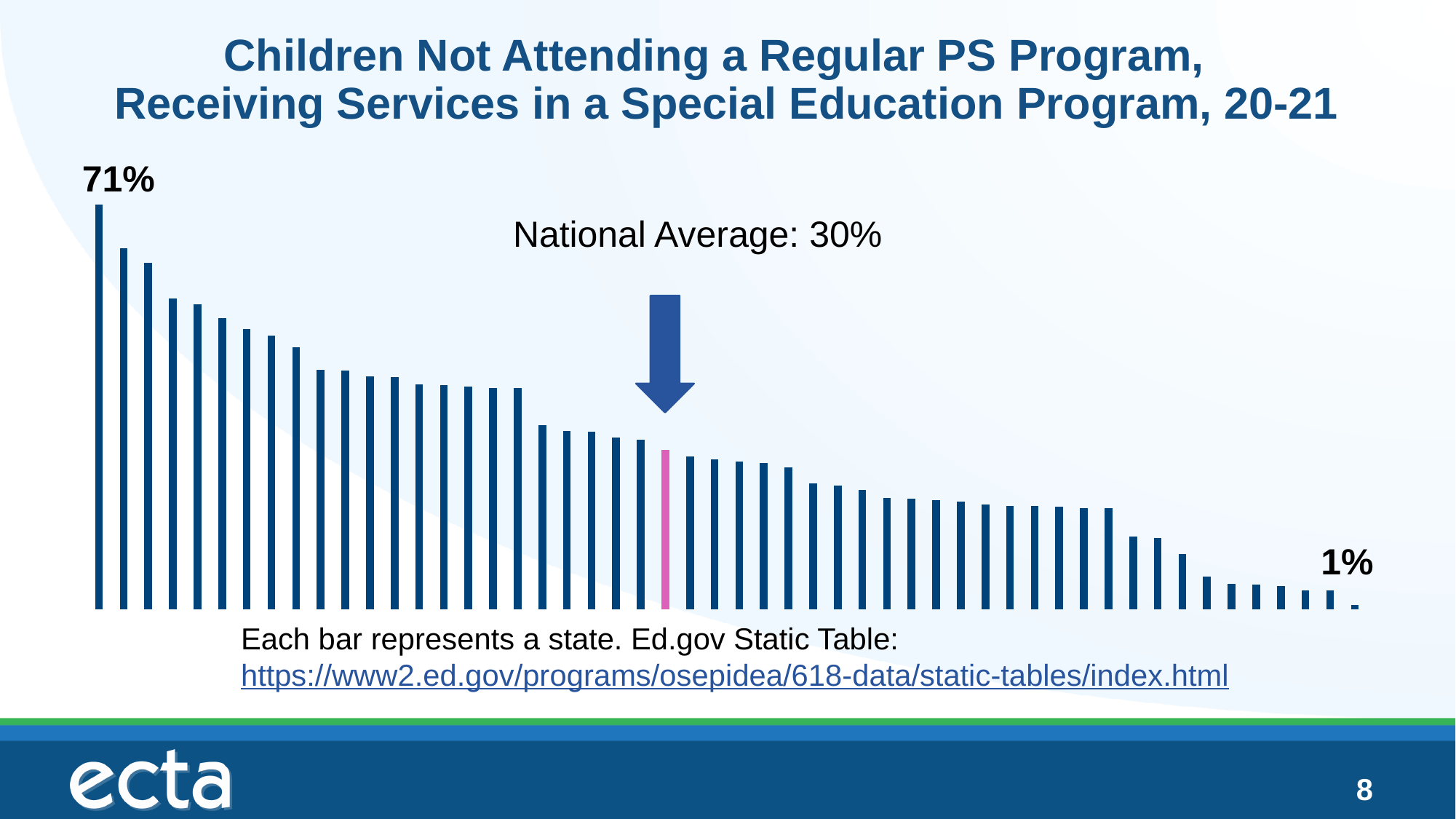
What kind of chart is shown on the slide? Bar chart Do the bar values rise or fall from left to right across the chart? Fall What is the lowest value shown on the chart? 1% What does each bar on the chart represent? A state What is the highest value shown on the chart? 71% What is the title of the chart? Children Not Attending a Regular PS Program, Receiving Services in a Special Education Program, 20-21 Which is larger, the leftmost bar or the rightmost bar? The leftmost bar What is the national average shown on the chart? 30% What is the difference between the highest value (71%) and the lowest value (1%) on the chart? 70 percentage points Is the value of the shortest bar greater or less than the national average of 30%? Less Is the value of the tallest bar greater or less than the national average of 30%? Greater